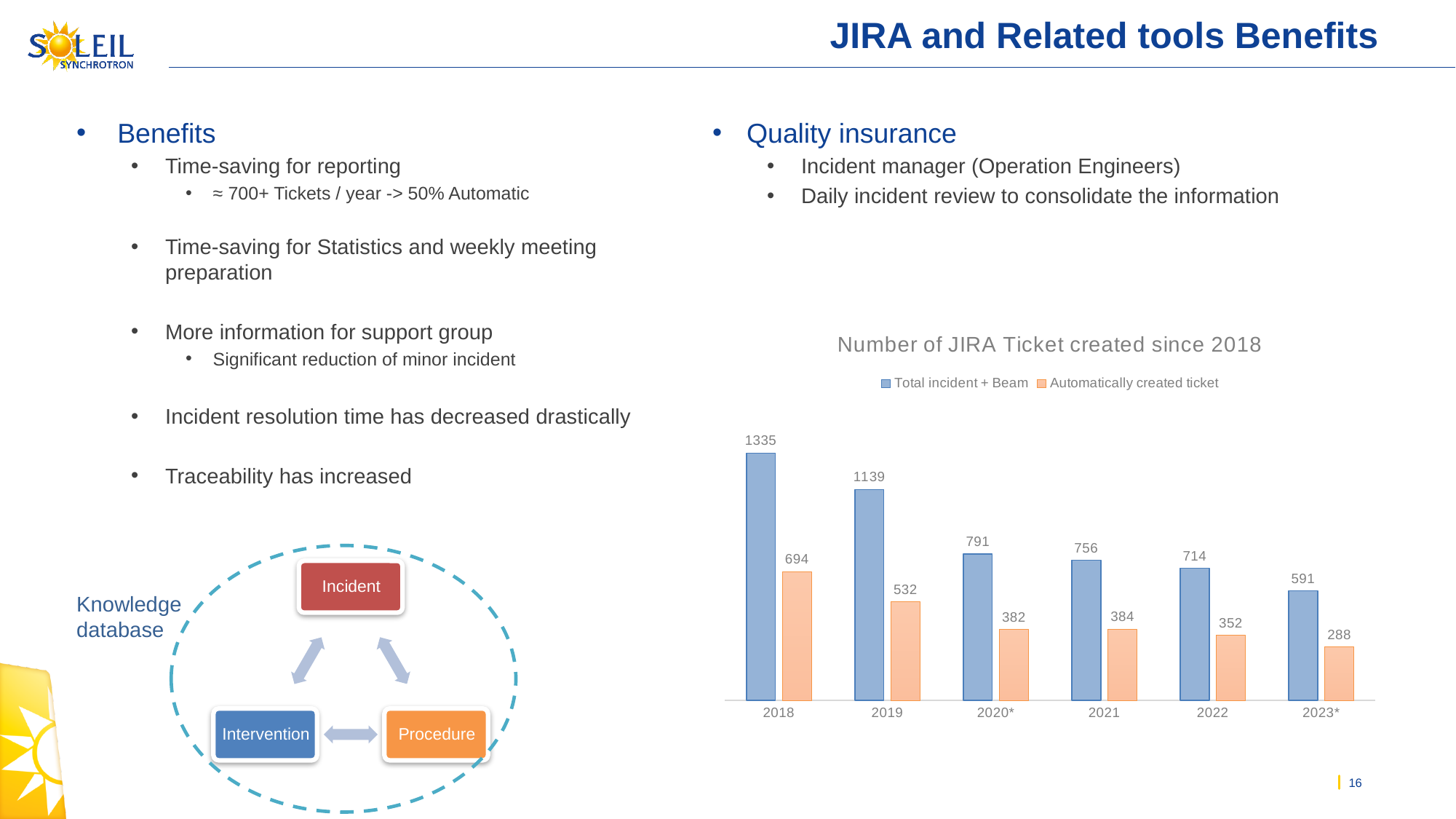
How many years are shown on the x axis? 6 Which year has the highest value for Automatically created ticket? 2018 Which year has the lowest value for Total incident + Beam? 2023* What is the title of the chart? Number of JIRA Ticket created since 2018 Which is larger: Automatically created ticket in 2020* or in 2021? 2021 Do the Total incident + Beam values rise or fall from 2018 to 2023*? fall What is the value for Automatically created ticket in 2021? 384 How many series does the legend list? 2 What is the value for Total incident + Beam in 2023*? 591 What is the difference between Total incident + Beam and Automatically created ticket in 2019? 607 What is the value for Total incident + Beam in 2018? 1335 What kind of chart is shown? bar chart